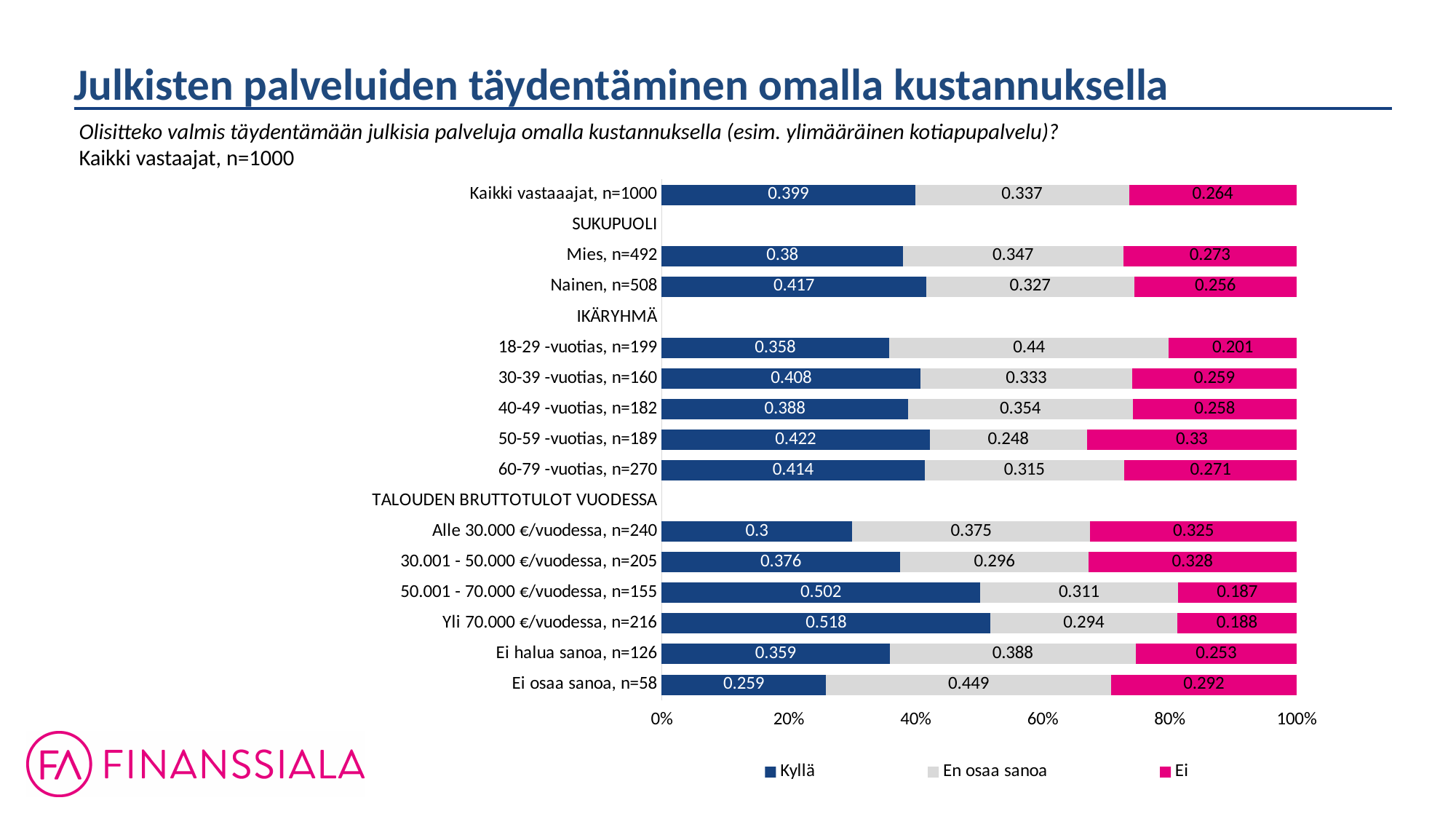
Which has the larger Ei value: 18-29 -vuotias, n=199 or 50-59 -vuotias, n=189? 50-59 -vuotias, n=189 What is the difference between the Kyllä values for Nainen, n=508 and Mies, n=492? 0.037 Is the Kyllä value for 50.001 - 70.000 €/vuodessa, n=155 greater or less than 40%? greater What is the Ei value for 50-59 -vuotias, n=189? 0.33 What is the difference between the Ei values for Alle 30.000 €/vuodessa, n=240 and Yli 70.000 €/vuodessa, n=216? 0.137 What is the Kyllä value for Nainen, n=508? 0.417 What is the En osaa sanoa value for 18-29 -vuotias, n=199? 0.44 What kind of chart is shown on the slide? Stacked bar chart How many series does the legend list? 3 Which category has the lowest Kyllä value? Ei osaa sanoa, n=58 Which category has the highest Kyllä value? Yli 70.000 €/vuodessa, n=216 How many categories have bars plotted in the chart? 14